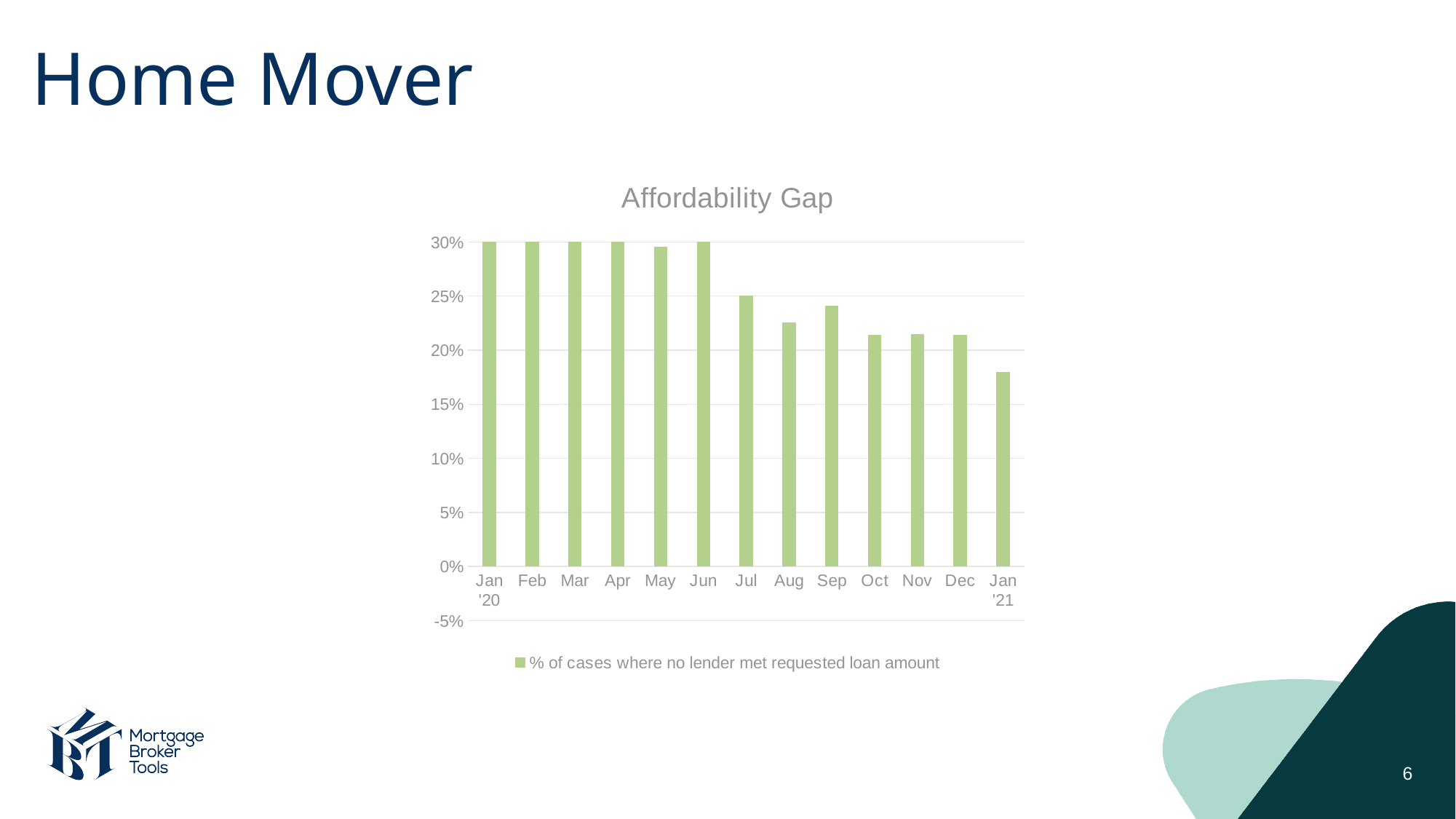
What is the value for Jan '20? 30% Which is larger, the value for Sep or the value for Aug? Sep What is the legend entry for the plotted series? % of cases where no lender met requested loan amount How many series does the legend list? 1 What is the title of the chart? Affordability Gap What type of chart is shown on the slide? Bar chart What is the value for Jul? 25% Which month has the lowest value? Jan '21 How many months (categories) are plotted on the x axis? 13 Do the values generally rise or fall from Jan '20 to Jan '21? Fall Is the value for Aug greater or less than 25%? less Is the value for Jan '21 greater or less than 20%? less